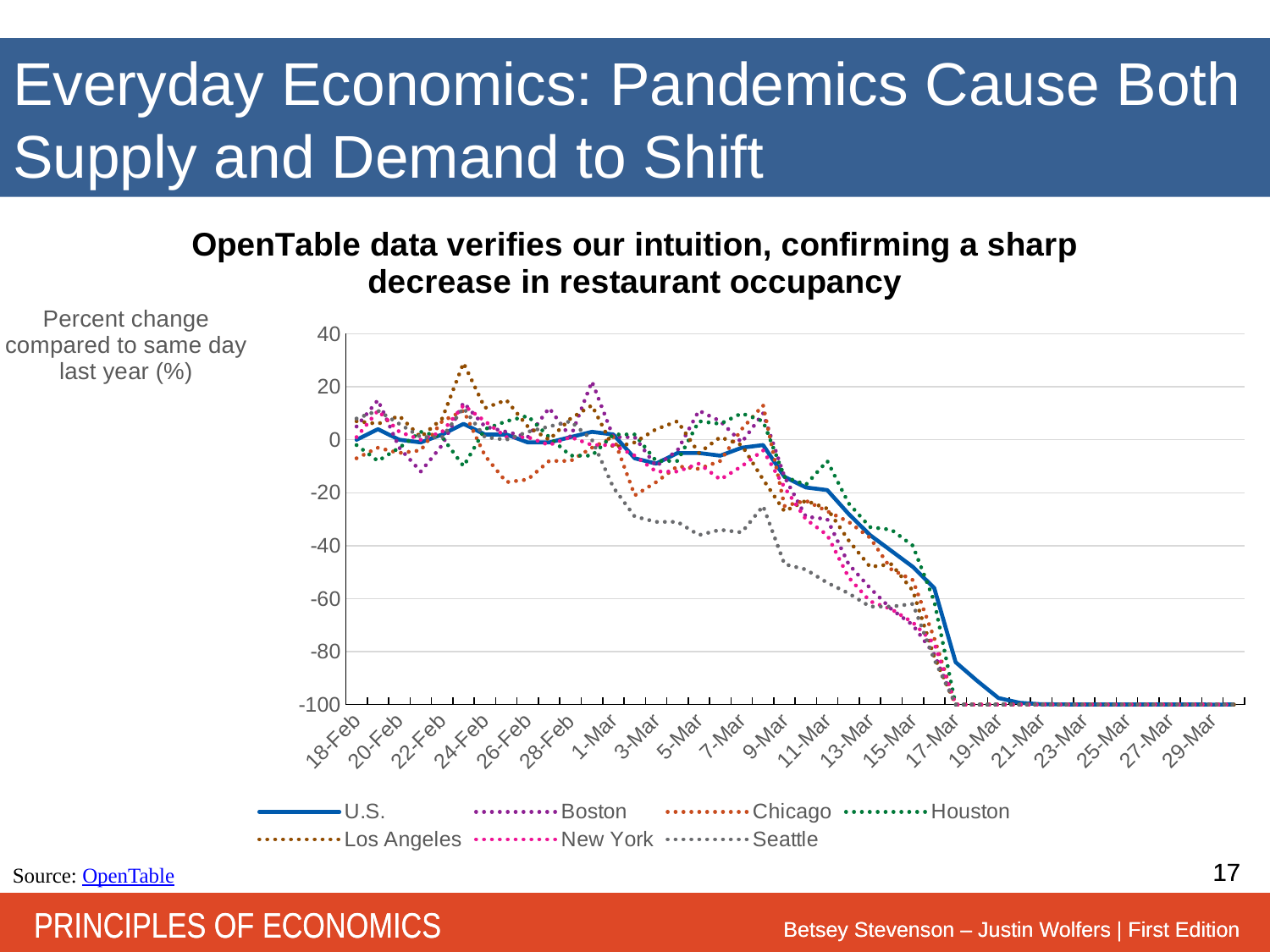
What is the value for U.S. on 29-Mar? -100 How many series does the legend list? 7 Is the value for U.S. on 13-Mar greater or less than -20? less Is the value for U.S. on 18-Feb greater or less than -20? greater Is the value for Seattle on 9-Mar greater or less than -20? less How many date labels are shown on the x axis? 21 What kind of chart is shown on the slide? line chart What is the y-axis label of the chart? Percent change compared to same day last year (%) Which series has the lowest value on 9-Mar? Seattle On 9-Mar, which is lower, Seattle or U.S.? Seattle Which series is drawn as a solid line rather than a dotted line? U.S. Overall, do the values rise or fall from 18-Feb to 29-Mar? fall